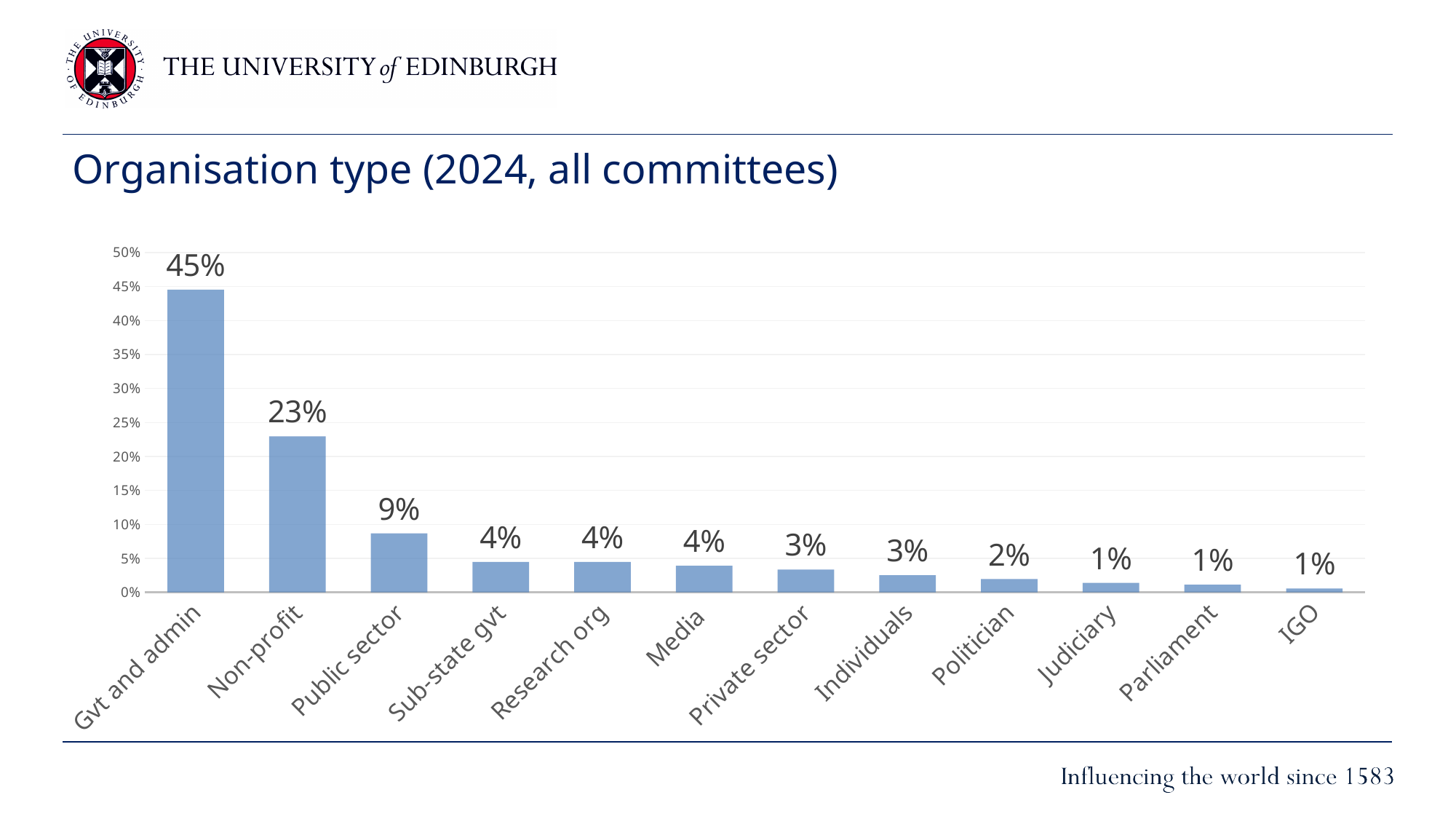
What is the difference between the values for Gvt and admin and Non-profit? 22% Which is larger, the value for Non-profit or the value for Public sector? Non-profit What is the value for Non-profit? 23% What is the value for Public sector? 9% Which organisation type has the highest value? Gvt and admin What is the difference between the values for Public sector and Media? 5% Is the value for Gvt and admin greater or less than 40%? greater What is the value for Politician? 2% How many organisation types are shown on the x axis? 12 What is the title of the chart? Organisation type (2024, all committees) What type of chart is shown on the slide? bar chart What is the value for Gvt and admin? 45%